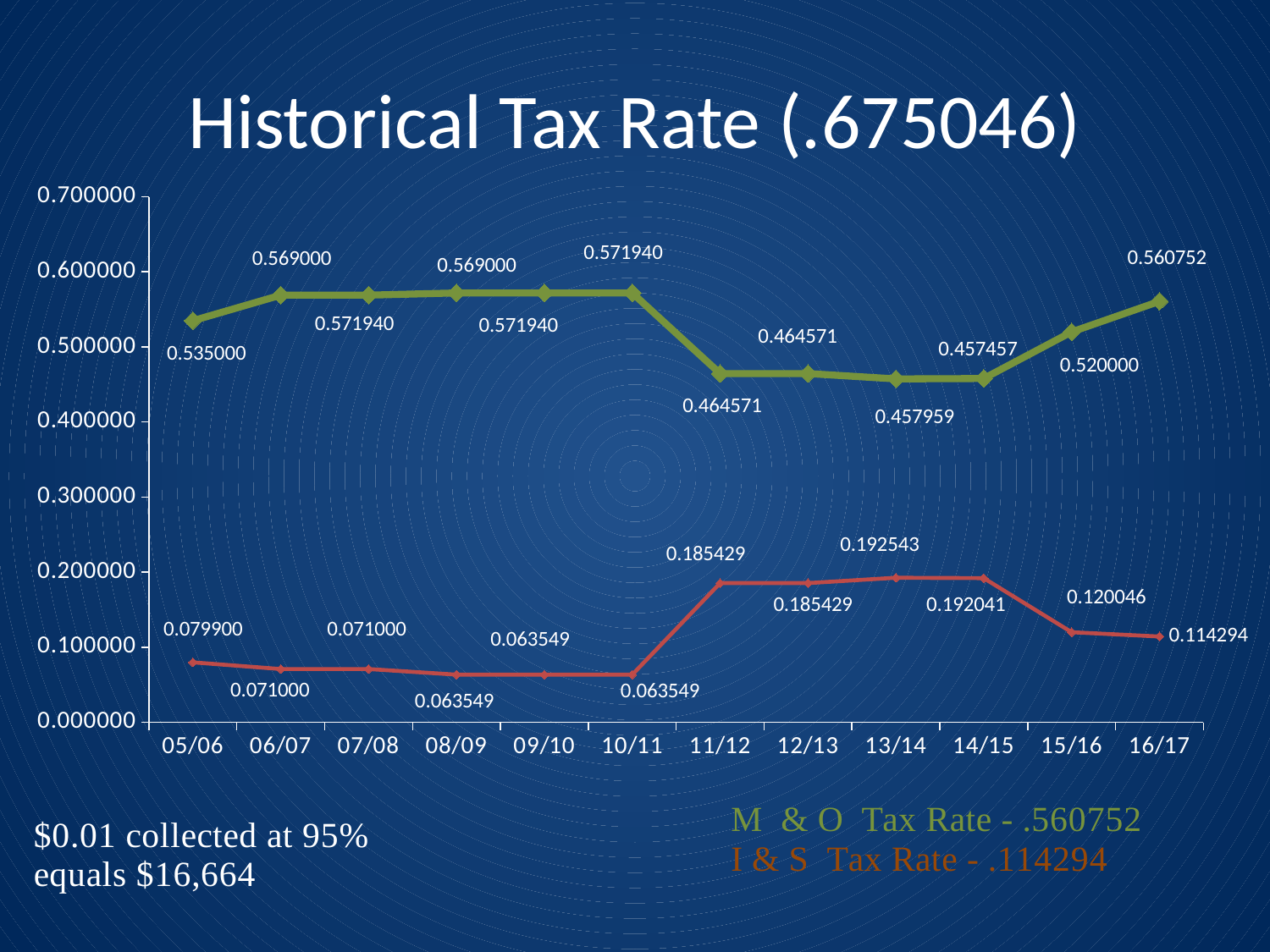
What kind of chart is shown on the slide? line chart What is the I & S Tax Rate for 16/17? 0.114294 How many series are plotted on the chart? 2 What is the M & O Tax Rate for 15/16? 0.520000 Is the M & O Tax Rate for 05/06 greater or less than 0.500000? greater What is the I & S Tax Rate for 11/12? 0.185429 What is the difference between the M & O Tax Rate for 16/17 and for 15/16? 0.040752 Does the I & S Tax Rate rise or fall from 14/15 to 16/17? fall How many years are plotted on the x axis? 12 Which is larger at 16/17, the M & O Tax Rate or the I & S Tax Rate? M & O Tax Rate What is the title of the chart? Historical Tax Rate (.675046) What is the M & O Tax Rate for 05/06? 0.535000